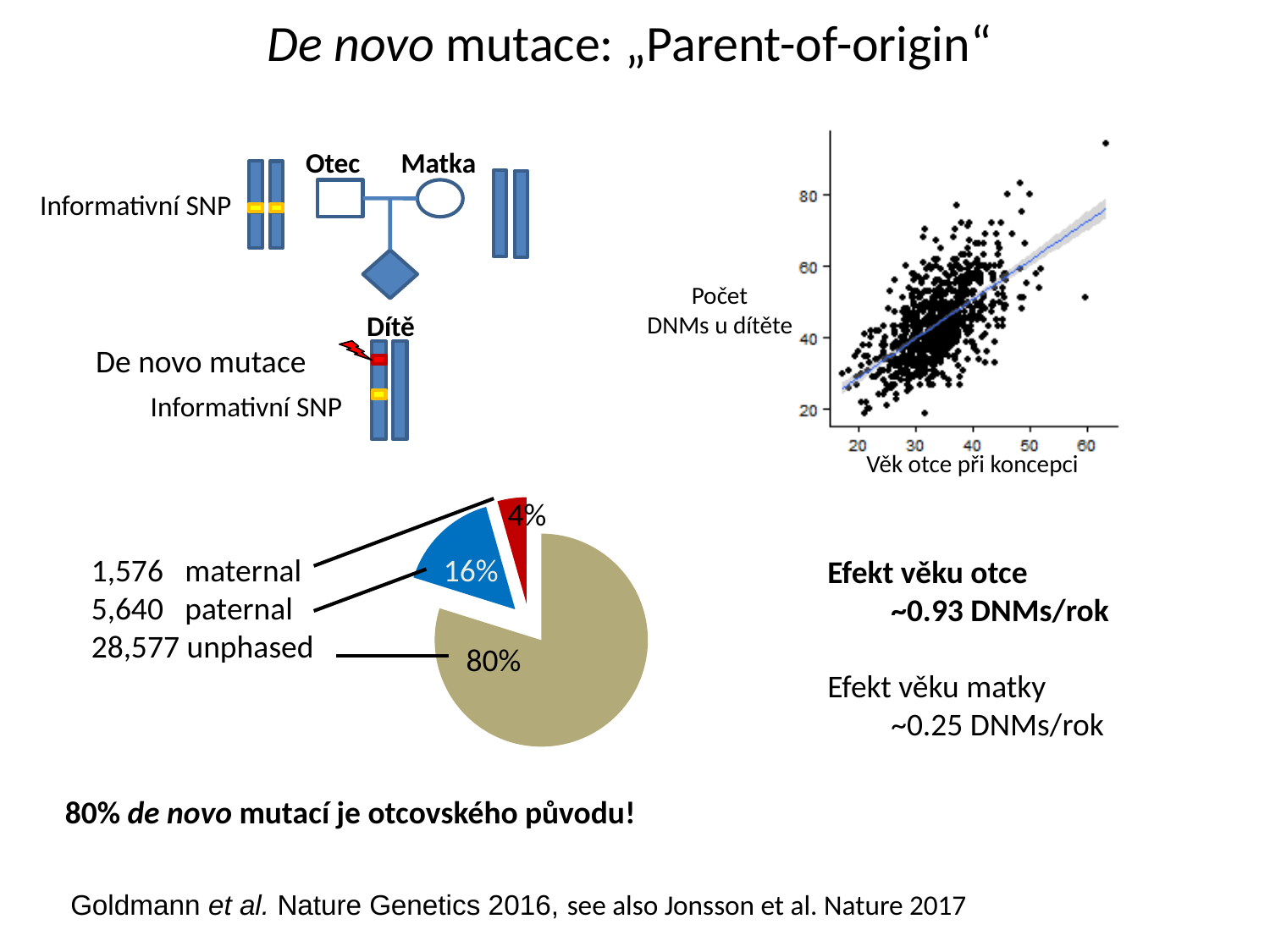
According to the pie chart labels, how many de novo mutations are paternal? 5,640 What kind of chart is the chart in the upper right of the slide? scatter plot In the pie chart, which category has the smallest slice? maternal In the pie chart, which is larger, the paternal slice or the maternal slice? paternal In the pie chart, which category has the largest slice? unphased In the pie chart, what is the difference in percentage points between the unphased slice and the paternal slice? 64 percentage points In the pie chart, what share of de novo mutations is paternal? 16% In the scatter plot in the upper right, does the number of DNMs in the child rise or fall as the father's age at conception increases? rise In the pie chart, what share of de novo mutations is unphased? 80% What kind of chart is the chart in the lower left of the slide? pie chart How many slices does the pie chart have? 3 In the pie chart, what share of de novo mutations is maternal? 4%